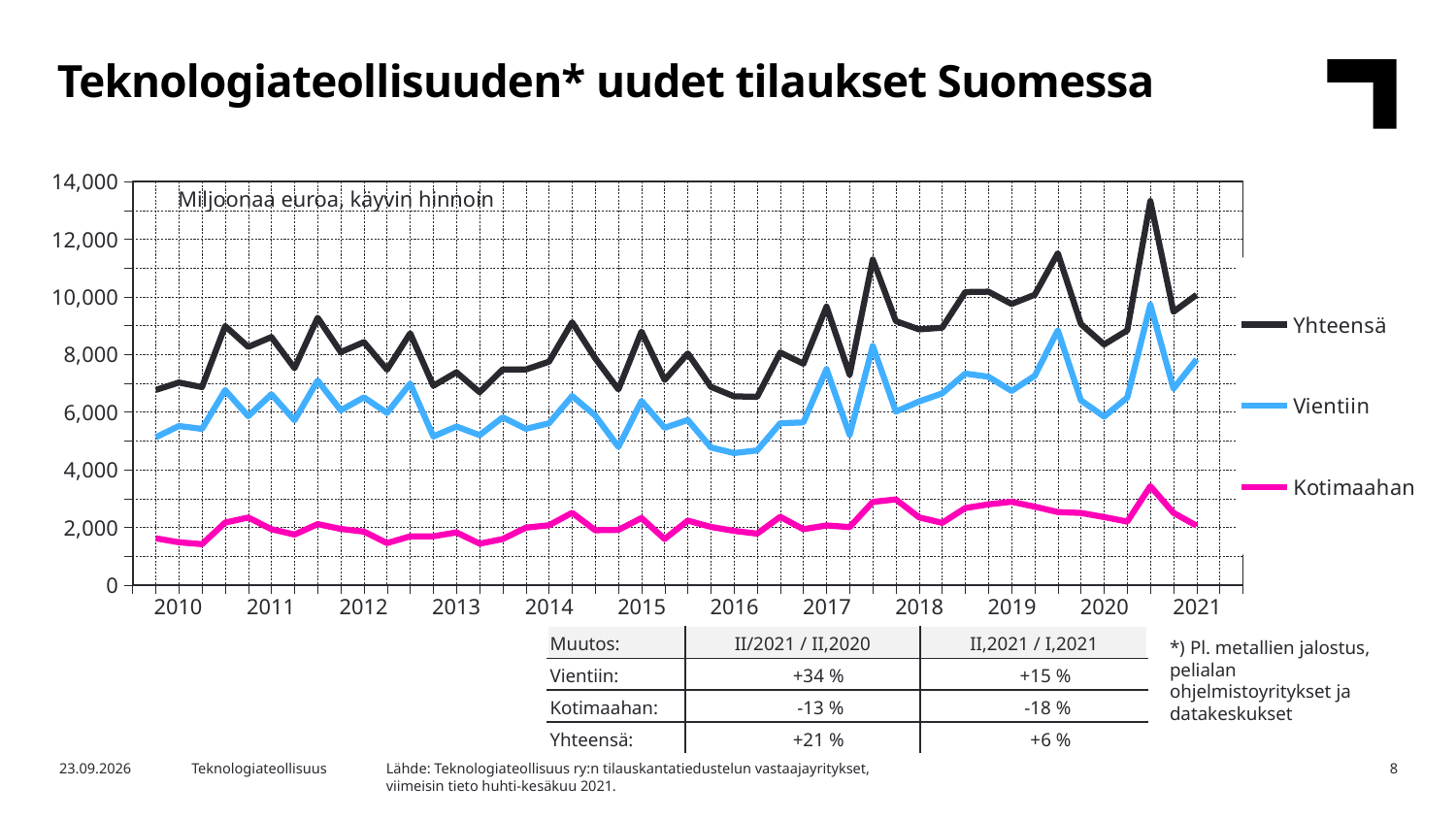
Which is larger at the start of 2010, the Vientiin value or the Kotimaahan value? Vientiin How many series does the legend list? 3 Does the Yhteensä series rise or fall from 2016 to 2017? rise Which series has the highest values throughout the chart? Yhteensä Is the peak value of the Kotimaahan series greater or less than 4,000? less Is the peak value of the Vientiin series in 2020 greater or less than 10,000? less What are the three series named in the legend? Yhteensä, Vientiin, Kotimaahan Which series has the lowest values throughout the chart? Kotimaahan How many years are labelled on the x axis? 12 What kind of chart is shown on the slide? line chart Is the peak value of the Yhteensä series in 2020 greater or less than 12,000? greater What is the title of the chart on the slide? Teknologiateollisuuden* uudet tilaukset Suomessa